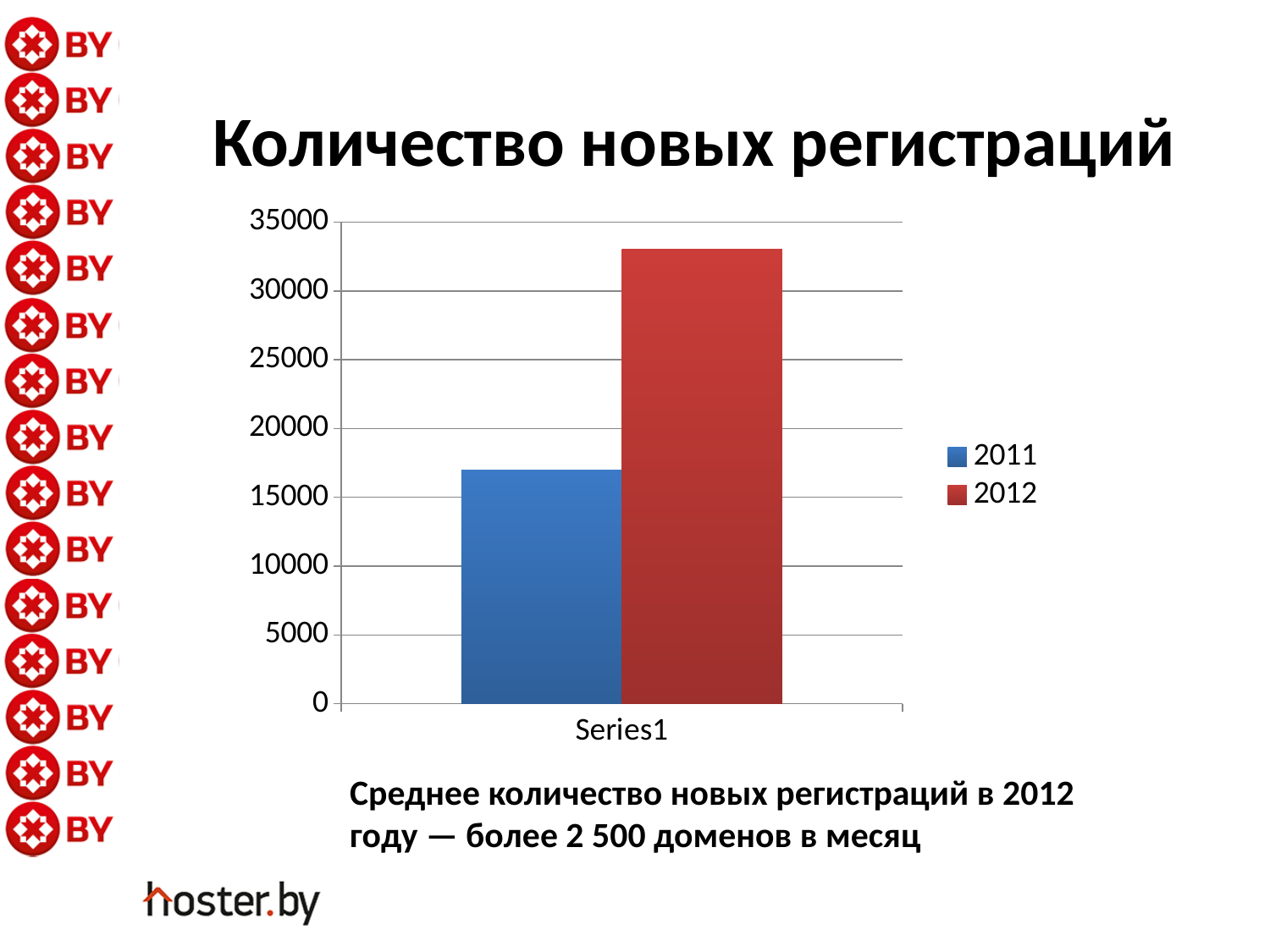
Is the value for 2011 greater or less than 15000? greater Which series has the higher bar, 2011 or 2012? 2012 What kind of chart is shown on the slide? bar chart What is the title of the chart? Количество новых регистраций Is the value for 2012 greater or less than 30000? greater What colour is the bar for the 2012 series? red How many categories are shown on the x axis? 1 Is the value for 2011 greater or less than 20000? less How many series does the legend list? 2 Which series has the highest value in the chart? 2012 Which series has the lowest value in the chart? 2011